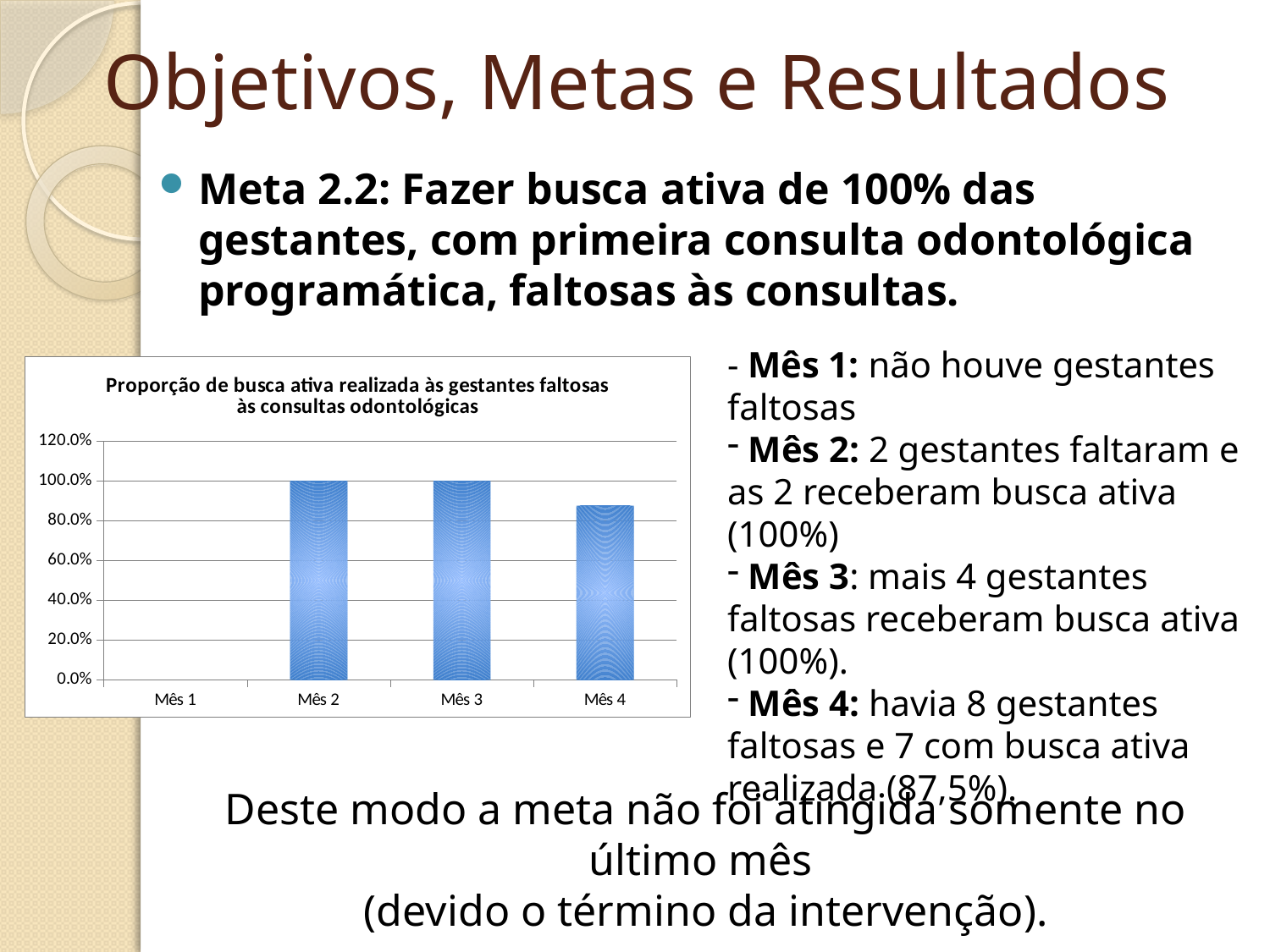
What is the value for Mês 3 in the chart? 100.0% What is the value for Mês 2 in the chart? 100.0% From Mês 3 to Mês 4, does the value rise or fall? fall What is the value for Mês 1 in the chart? 0.0% What type of chart is shown on the slide? bar chart How many months (categories) are shown on the x axis of the chart? 4 Which month has the lowest value in the chart? Mês 1 Is the value for Mês 4 greater or less than 80.0%? greater What is the title of the chart? Proporção de busca ativa realizada às gestantes faltosas às consultas odontológicas Is the value for Mês 4 greater or less than 100.0%? less What is the difference between the values for Mês 2 and Mês 1? 100.0% Which is larger, the value for Mês 2 or the value for Mês 4? Mês 2